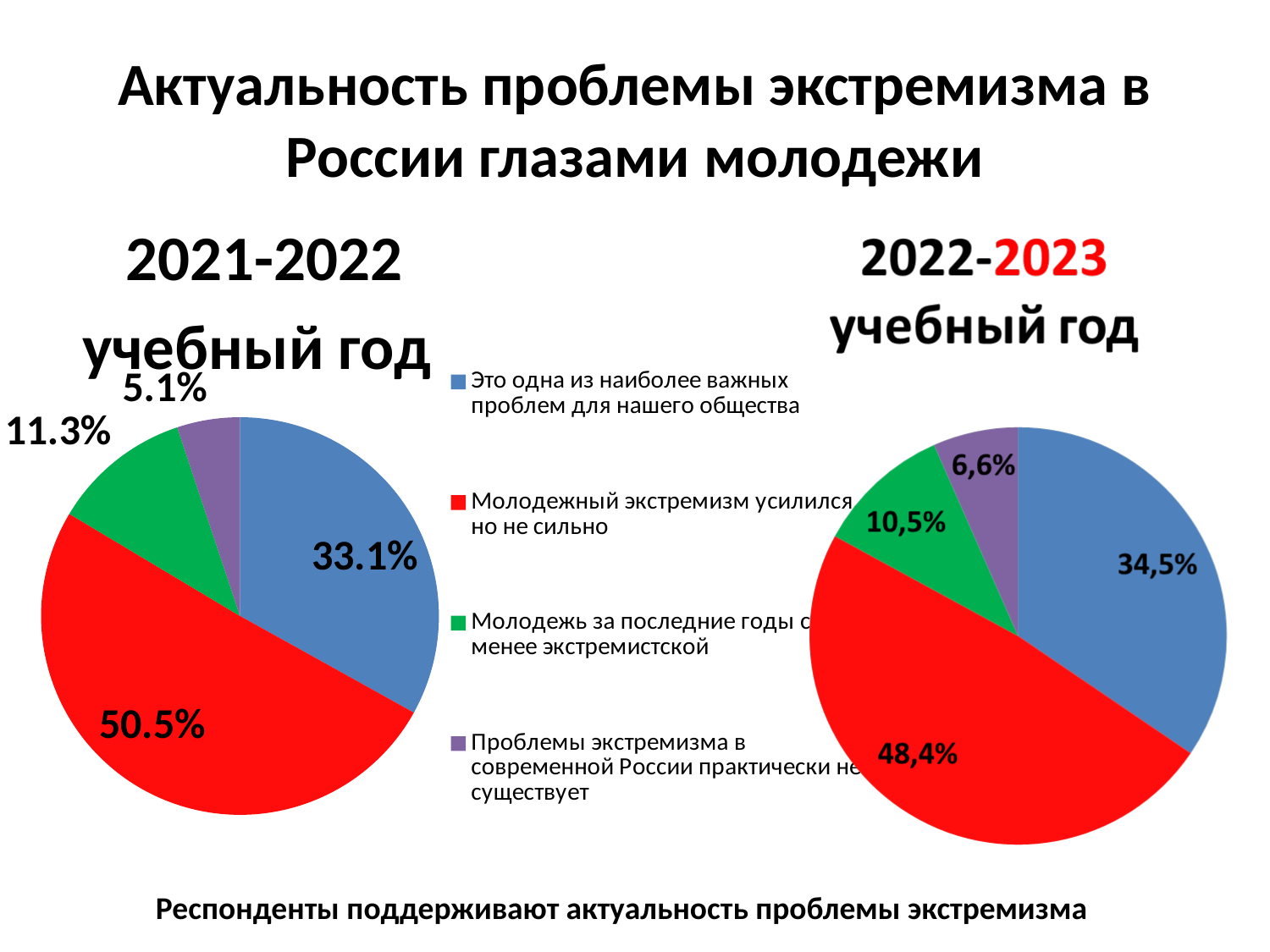
What kind of chart is the "2021-2022 учебный год" chart? pie chart In the "2021-2022 учебный год" chart, which slice is the largest? Молодежный экстремизм усилился, но не сильно How many slices does the "2022-2023 учебный год" pie chart have? 4 In the "2021-2022 учебный год" chart, what share is labelled for the red slice (Молодежный экстремизм усилился, но не сильно)? 50.5% What colour represents "Это одна из наиболее важных проблем для нашего общества" in the legend? blue In the "2022-2023 учебный год" chart, which slice is the smallest? Проблемы экстремизма в современной России практически не существует In the "2022-2023 учебный год" chart, what share is labelled for the purple slice (Проблемы экстремизма в современной России практически не существует)? 6,6% In the "2022-2023 учебный год" chart, what share is labelled for the red slice (Молодежный экстремизм усилился, но не сильно)? 48,4% In the "2022-2023 учебный год" chart, what is the difference between the green slice (10,5%) and the purple slice (6,6%)? 3,9% In the "2021-2022 учебный год" chart, what is the difference between the red slice (50.5%) and the blue slice (33.1%)? 17.4% Which is larger: the blue slice in the "2021-2022 учебный год" chart or the blue slice in the "2022-2023 учебный год" chart? 2022-2023 учебный год In the "2021-2022 учебный год" chart, what share is labelled for the blue slice (Это одна из наиболее важных проблем для нашего общества)? 33.1%